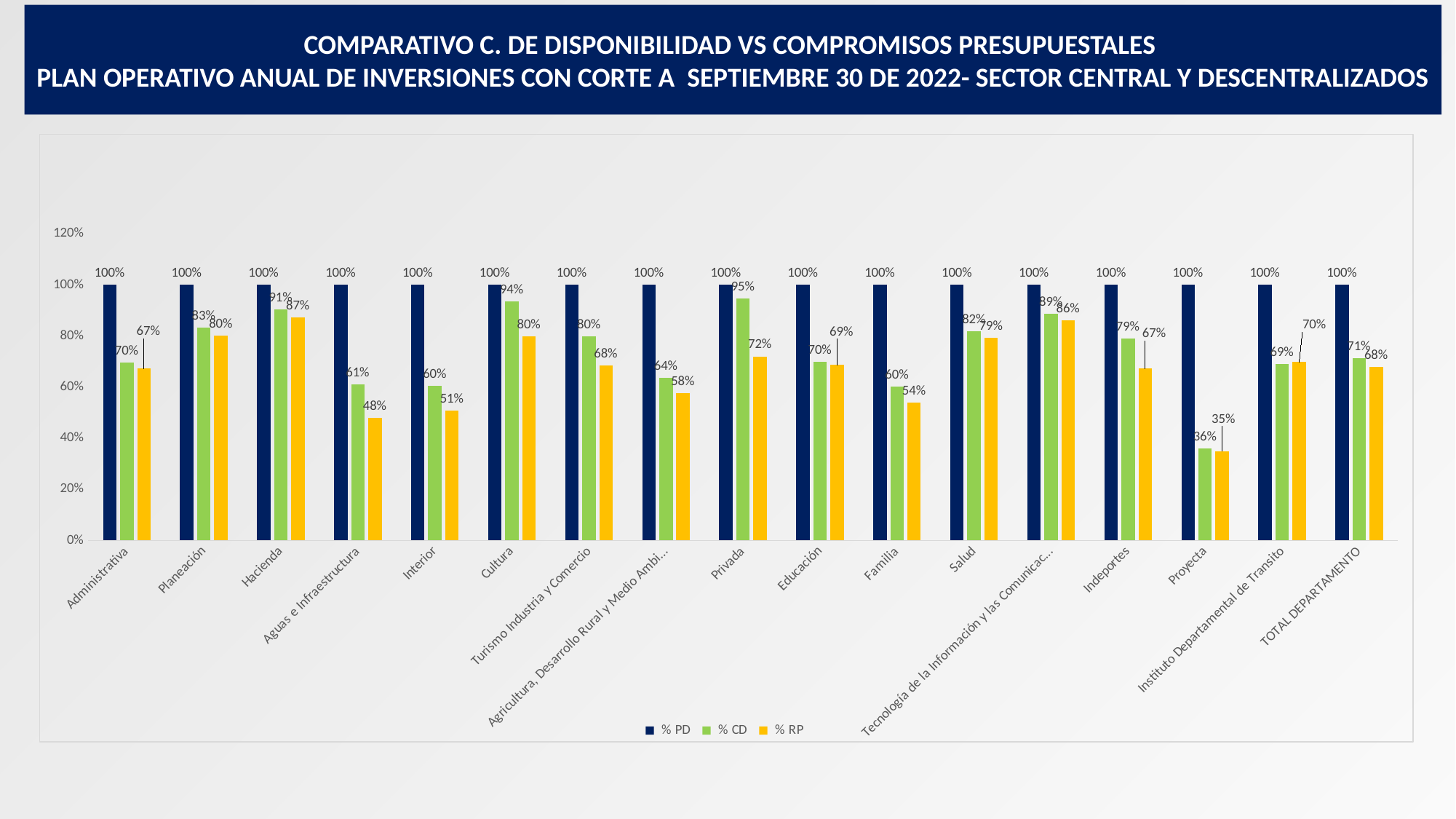
Which colour represents the % RP series in the legend? yellow Which is larger, the % RP value for Salud or the % RP value for Indeportes? Salud Which category has the highest % CD value? Privada What is the % CD value for Hacienda? 91% How many series does the legend list? 3 What is the % CD value for TOTAL DEPARTAMENTO? 71% What is the difference between the % CD and % RP values for Privada? 23% What kind of chart is shown on the slide? bar chart What is the % RP value for Aguas e Infraestructura? 48% Is the % CD value for Familia greater or less than 80%? less Which category has the lowest % RP value? Proyecta How many categories are shown on the x axis? 17